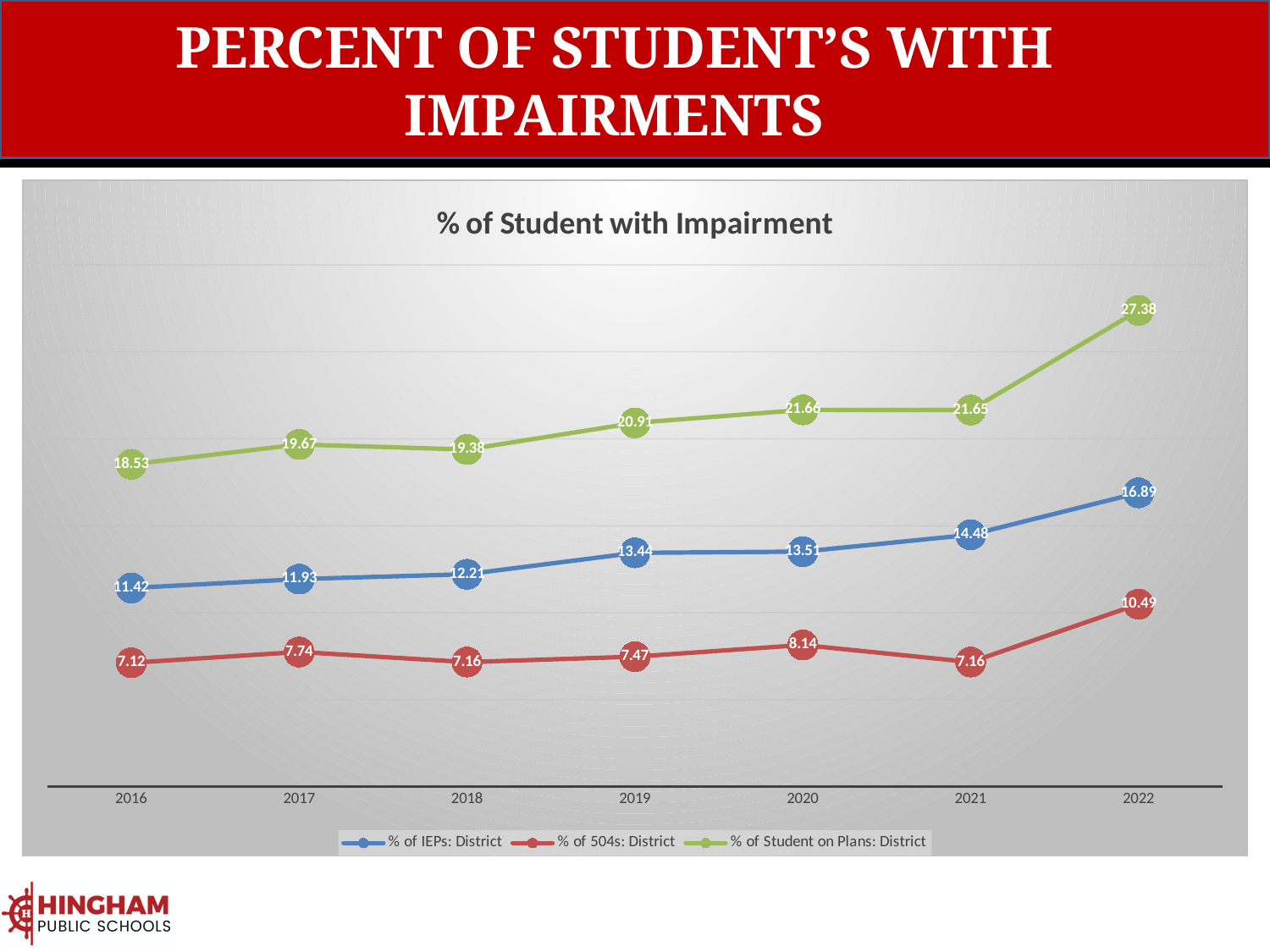
How many series does the legend list? 3 Does the % of IEPs: District series rise or fall from 2016 to 2022? Rise Which is larger in 2017: % of IEPs: District or % of 504s: District? % of IEPs: District What is the title of the chart? % of Student with Impairment What is the value for % of Student on Plans: District in 2022? 27.38 What is the value for % of IEPs: District in 2019? 13.44 What kind of chart is shown on the slide? Line chart In which year is the % of IEPs: District series lowest? 2016 In which year is the % of Student on Plans: District series highest? 2022 How many years are shown on the x axis? 7 What is the difference between the % of IEPs: District values in 2022 and 2016? 5.47 What is the value for % of 504s: District in 2020? 8.14